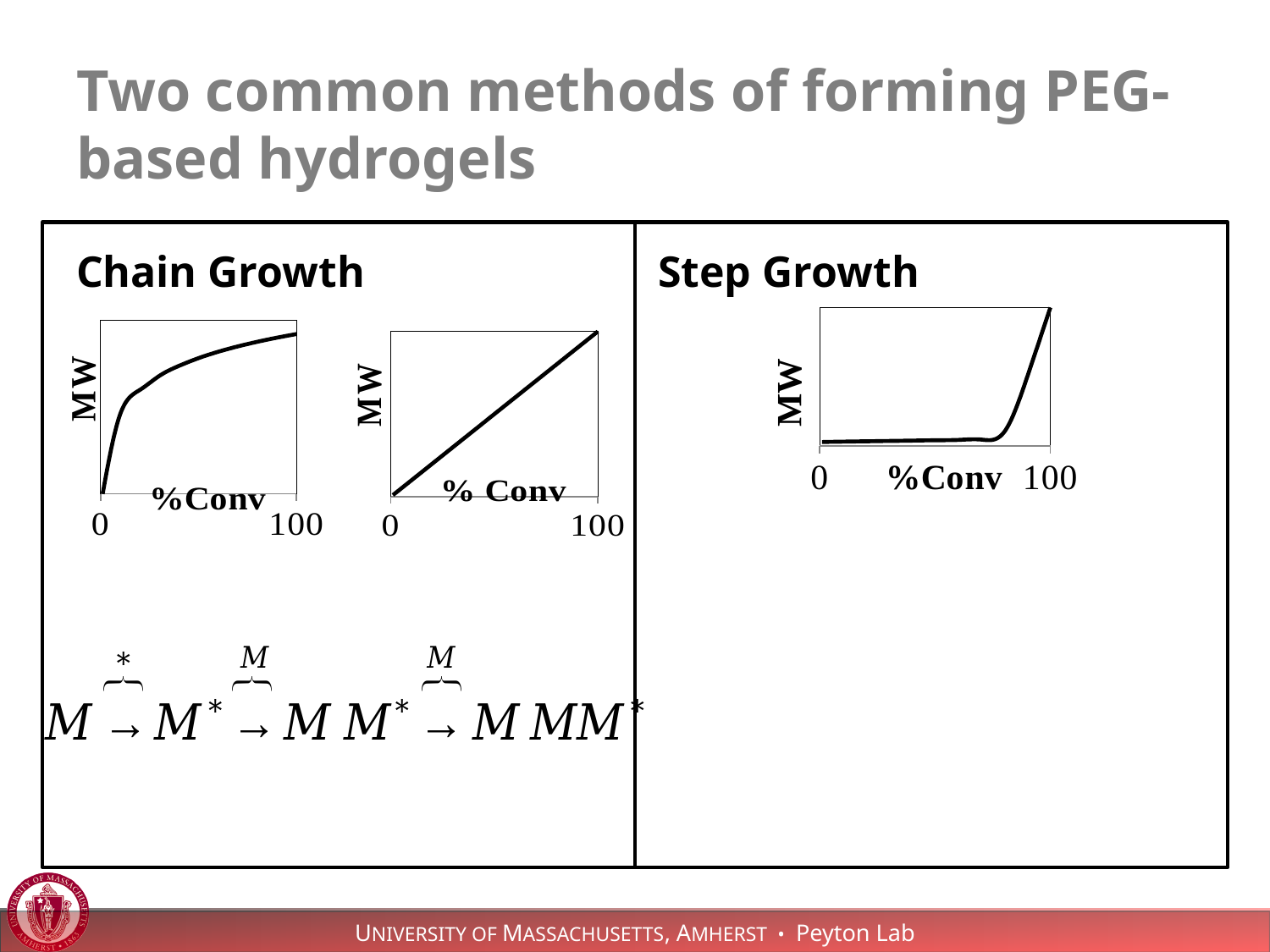
How many charts are shown under the Step Growth heading? 1 In the middle Chain Growth chart, does MW rise or fall as %Conv increases? rise How many charts are shown on the slide? 3 What kind of chart is shown under Step Growth? line chart What kind of chart is the leftmost chart under Chain Growth? line chart What is the minimum x-axis tick value shown on the middle Chain Growth chart? 0 What is the label on the x axis of the leftmost Chain Growth chart? %Conv In the Step Growth chart, does MW rise or fall as %Conv increases? rise What is the label on the y axis of the Step Growth chart? MW What is the maximum x-axis tick value shown on the Step Growth chart? 100 In the leftmost Chain Growth chart, does MW rise or fall as %Conv increases? rise How many charts are shown under the Chain Growth heading? 2